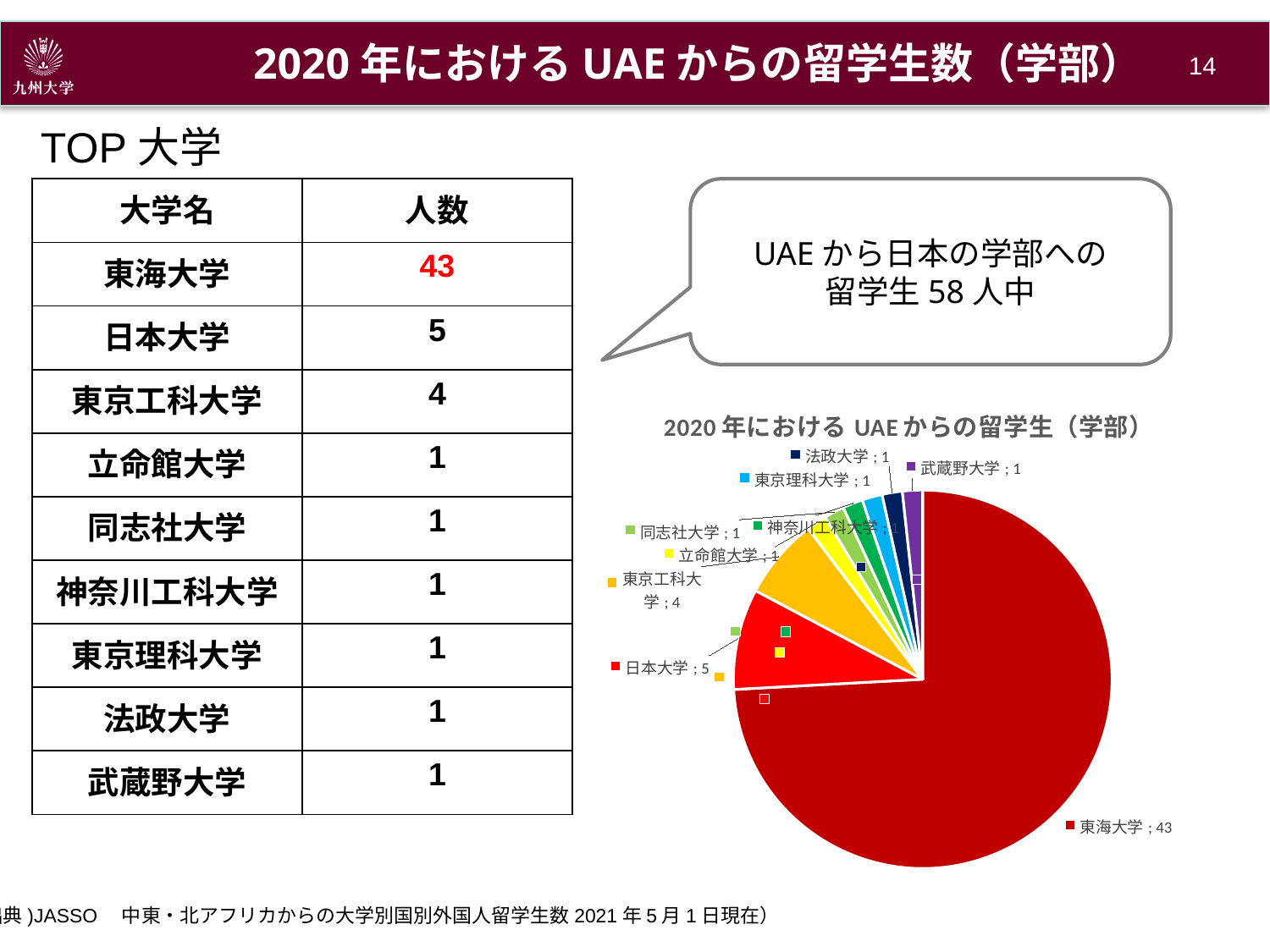
In the pie chart, what is the value for 東京工科大学? 4 In the pie chart, what is the value for 武蔵野大学? 1 What type of chart is shown on the slide? Pie chart Which is larger in the pie chart, the value for 日本大学 or 東京工科大学? 日本大学 Which university has the largest slice in the pie chart? 東海大学 What is the difference between the values for 東京工科大学 and 法政大学 in the pie chart? 3 In the pie chart, what is the value for 東海大学? 43 In the pie chart, what is the value for 日本大学? 5 What is the title of the pie chart? 2020年におけるUAEからの留学生（学部） What is the difference between the values for 東海大学 and 日本大学 in the pie chart? 38 How many universities (slices) are shown in the pie chart? 9 What colour is the slice for 東海大学 in the pie chart? Dark red